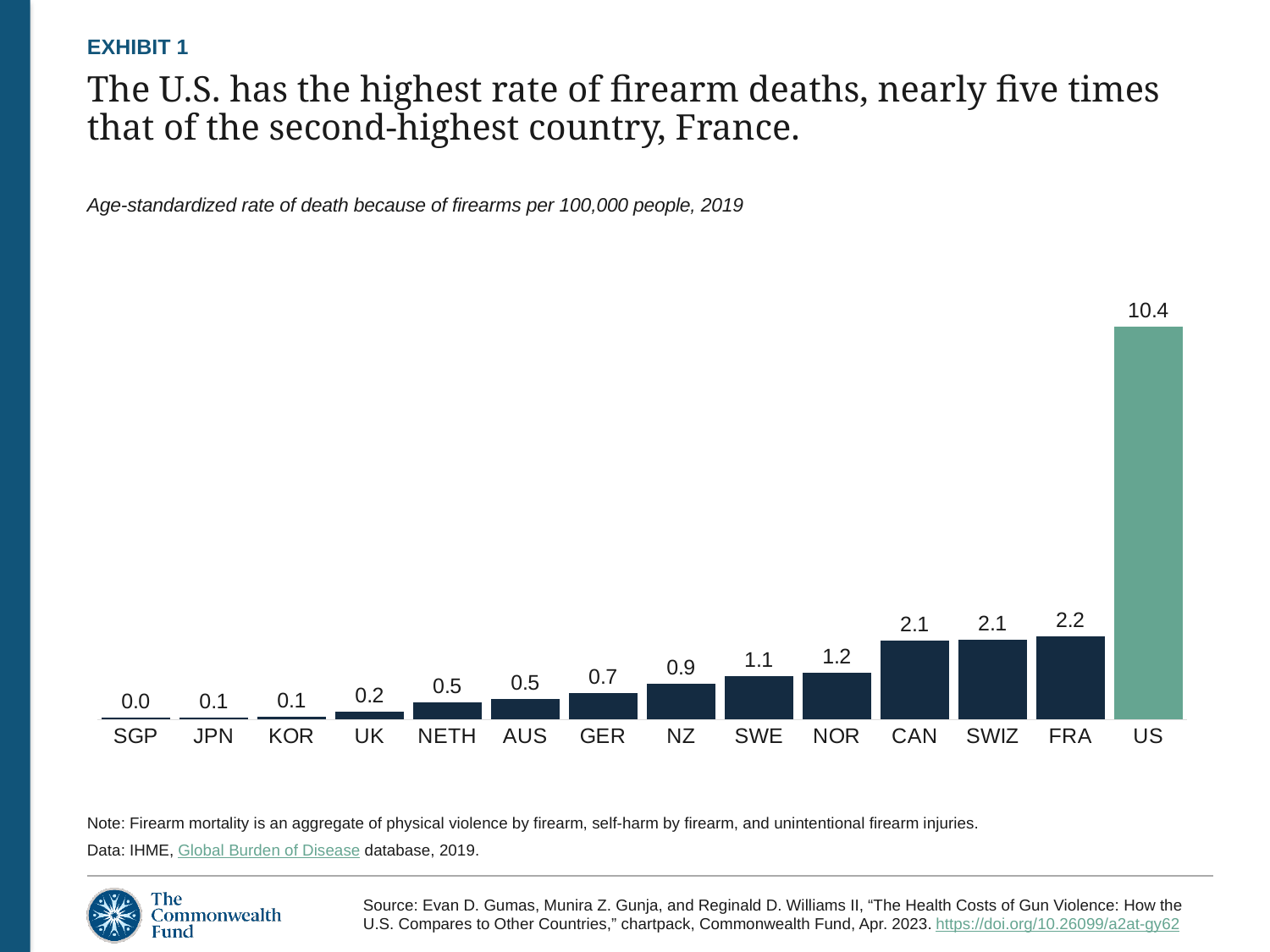
What is the firearm death rate shown for FRA? 2.2 Which has a higher firearm death rate, GER or NZ? NZ What is the firearm death rate shown for NETH? 0.5 Which country has the lowest firearm death rate on the chart? SGP What is the difference between the firearm death rates of NOR and SWE? 0.1 What is the age-standardized firearm death rate for the US? 10.4 How many countries are shown on the chart? 14 What kind of chart is shown on the slide? Bar chart Which bar is shown in a different colour from the others? US Do the values rise or fall moving from left to right along the x axis? Rise What is the difference between the firearm death rates of the US and FRA? 8.2 Which country has the highest firearm death rate on the chart? US